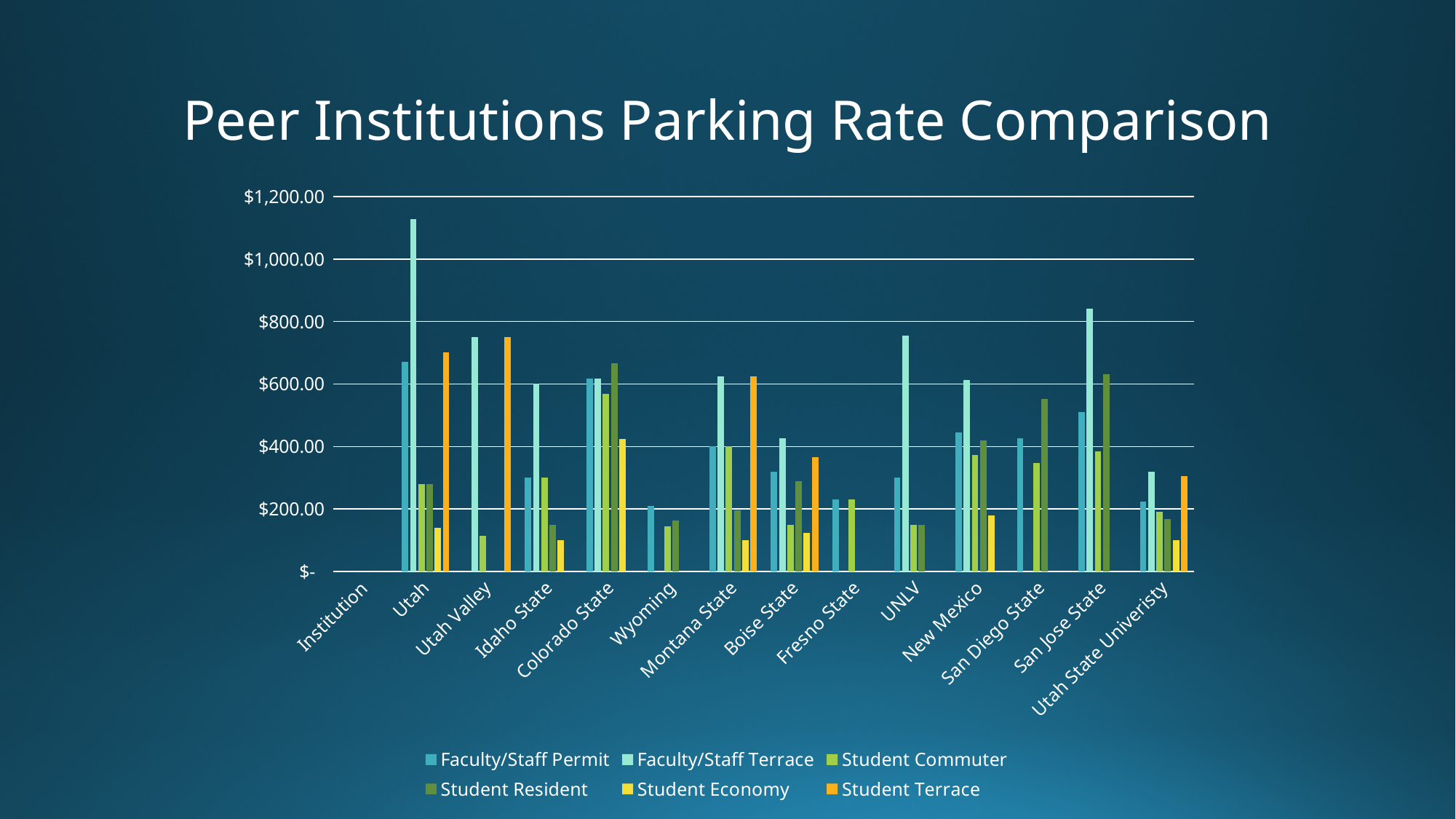
Which institution has the tallest bar in the chart? Utah Which is larger for Idaho State: Faculty/Staff Permit or Faculty/Staff Terrace? Faculty/Staff Terrace Is the Faculty/Staff Terrace value for UNLV greater or less than $800.00? less Is the Faculty/Staff Terrace value for San Jose State greater or less than $800.00? greater Is the Faculty/Staff Terrace value for Utah greater or less than $1,000.00? greater How many series does the legend list? 6 Which colour represents the Student Terrace series in the legend? Orange Which series has the highest value for Utah? Faculty/Staff Terrace What kind of chart is shown on the slide? Bar chart Which is larger for Colorado State: Student Commuter or Student Resident? Student Resident What is the title of the chart? Peer Institutions Parking Rate Comparison